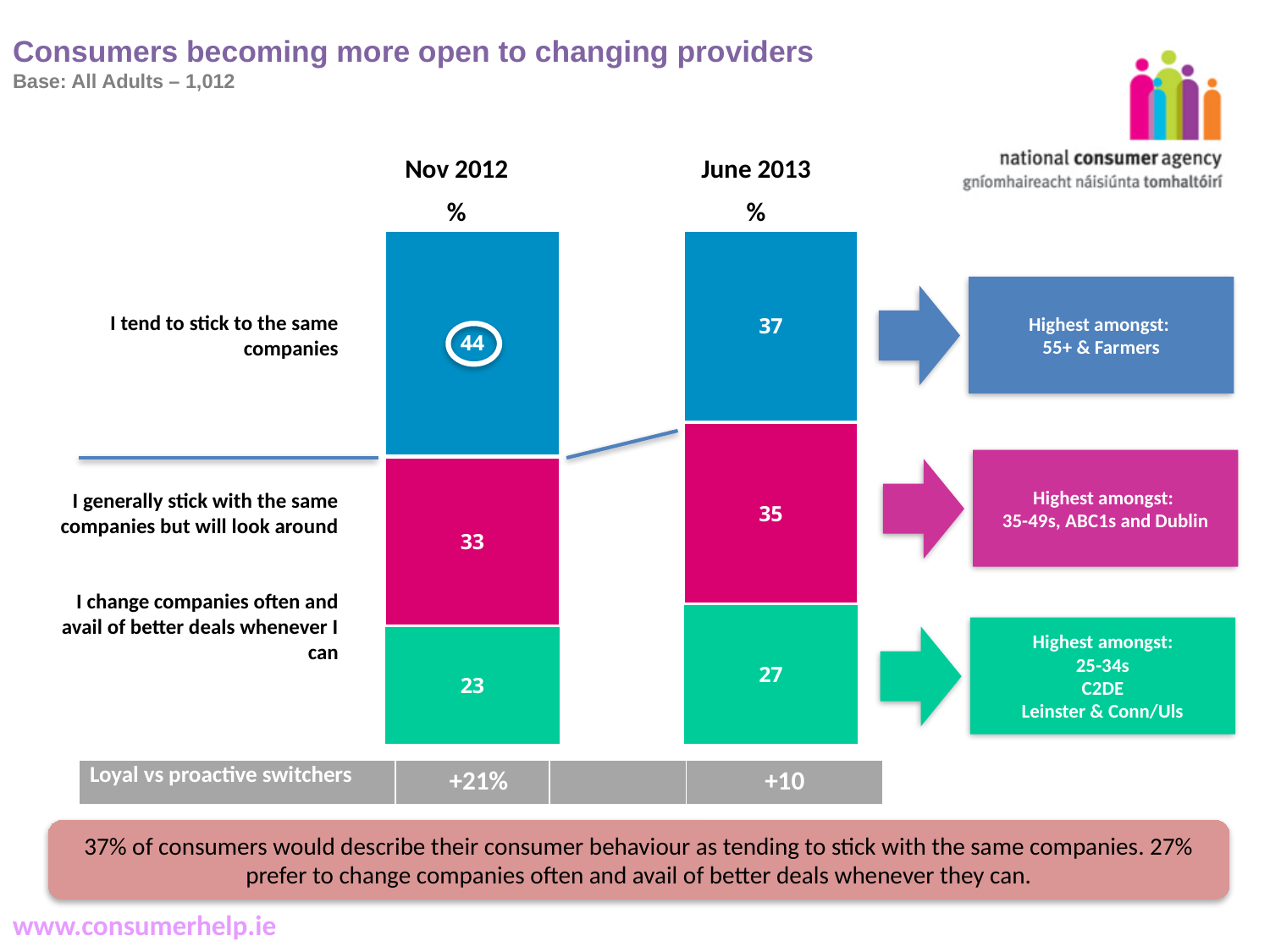
By how many percentage points did 'I tend to stick to the same companies' fall from Nov 2012 to June 2013? 7 What percentage of consumers said 'I tend to stick to the same companies' in June 2013? 37 How many statements (segments) make up each stacked bar? 3 How many time periods (bars) are shown in the chart? 2 What percentage of consumers said 'I tend to stick to the same companies' in Nov 2012? 44 Which is larger: the June 2013 value for 'I change companies often and avail of better deals whenever I can' or the Nov 2012 value for the same statement? June 2013 What is the 'Loyal vs proactive switchers' figure shown for June 2013? +10 Which statement had the highest share in Nov 2012? I tend to stick to the same companies What value is shown for 'I generally stick with the same companies but will look around' in June 2013? 35 What type of chart is shown on the slide? Stacked bar chart Which statement had the lowest share in June 2013? I change companies often and avail of better deals whenever I can What value is shown for 'I change companies often and avail of better deals whenever I can' in Nov 2012? 23